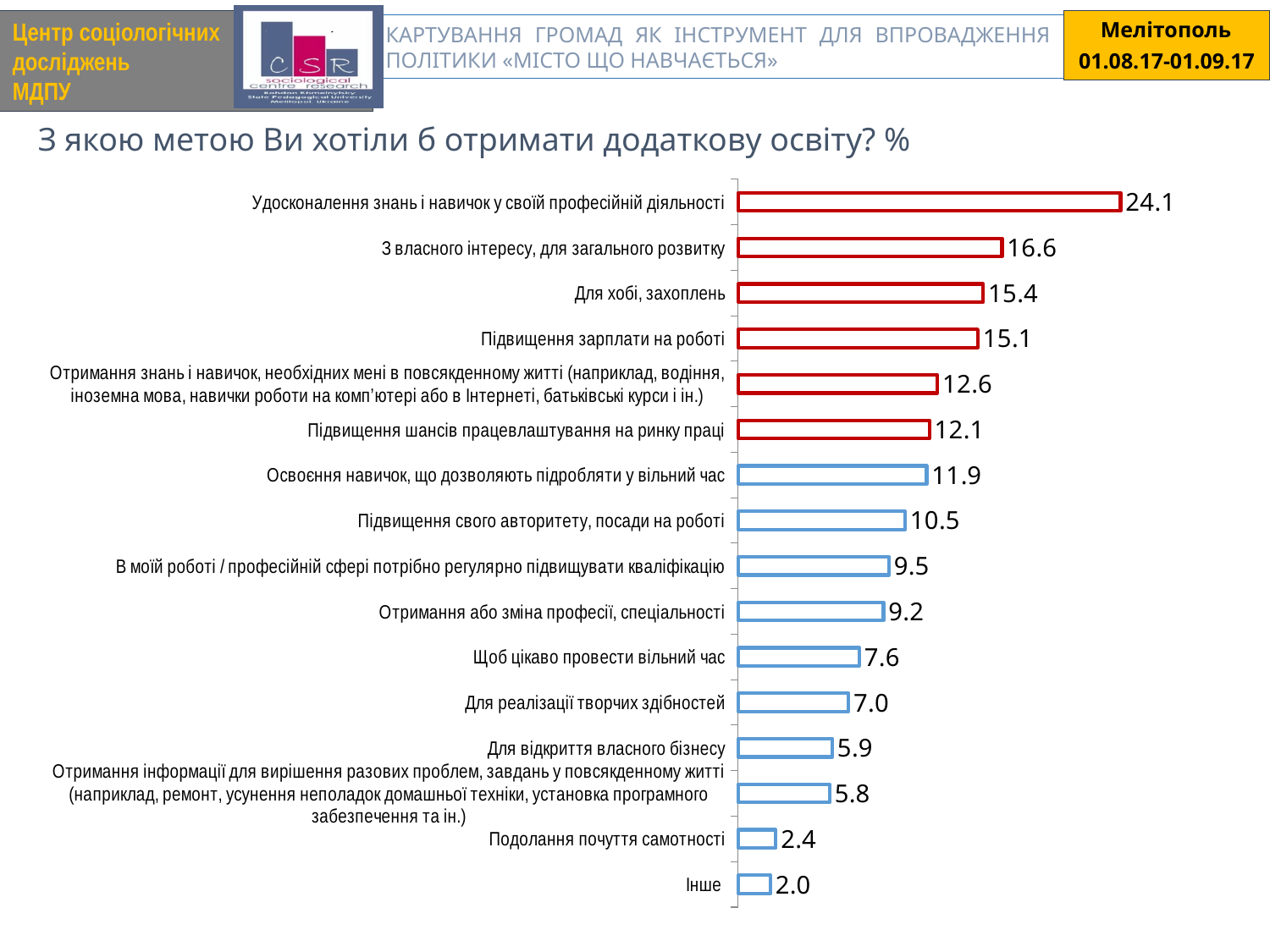
What is the value for "Удосконалення знань і навичок у своїй професійній діяльності"? 24.1 Which category has the highest value? Удосконалення знань і навичок у своїй професійній діяльності What is the difference between "З власного інтересу, для загального розвитку" and "Підвищення зарплати на роботі"? 1.5 What is the value for "Для хобі, захоплень"? 15.4 What is the difference between "Подолання почуття самотності" and "Інше"? 0.4 How many categories are shown in the chart? 16 What is the title of the chart? З якою метою Ви хотіли б отримати додаткову освіту? % What kind of chart is shown on the slide? Bar chart What is the value for "Для відкриття власного бізнесу"? 5.9 Which category has the lowest value? Інше What colour are the bars for the six highest categories? Red Which is larger: "Щоб цікаво провести вільний час" or "Для реалізації творчих здібностей"? Щоб цікаво провести вільний час